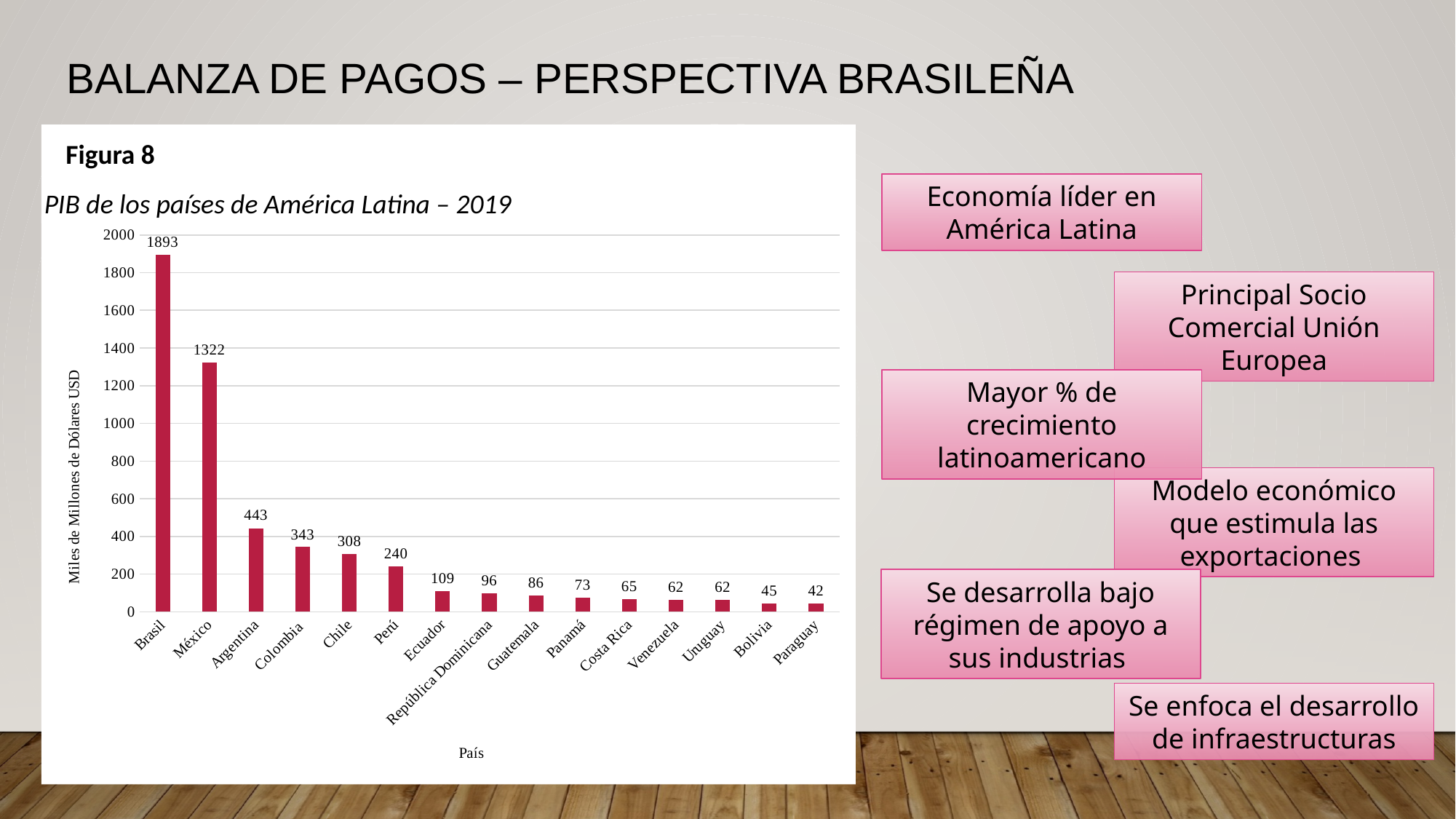
What is the difference between the values for Brasil and México? 571 Is the value for México greater or less than 1200? greater What is the value for Colombia? 343 What is the label of the y axis? Miles de Millones de Dólares USD Which is larger, the value for Perú or the value for Ecuador? Perú Which country has the highest value? Brasil What kind of chart is shown? bar chart How many countries are shown on the x axis? 15 What is the value for Ecuador? 109 Which country has the lowest value? Paraguay What is the difference between the values for Argentina and Chile? 135 What is the value for Brasil? 1893